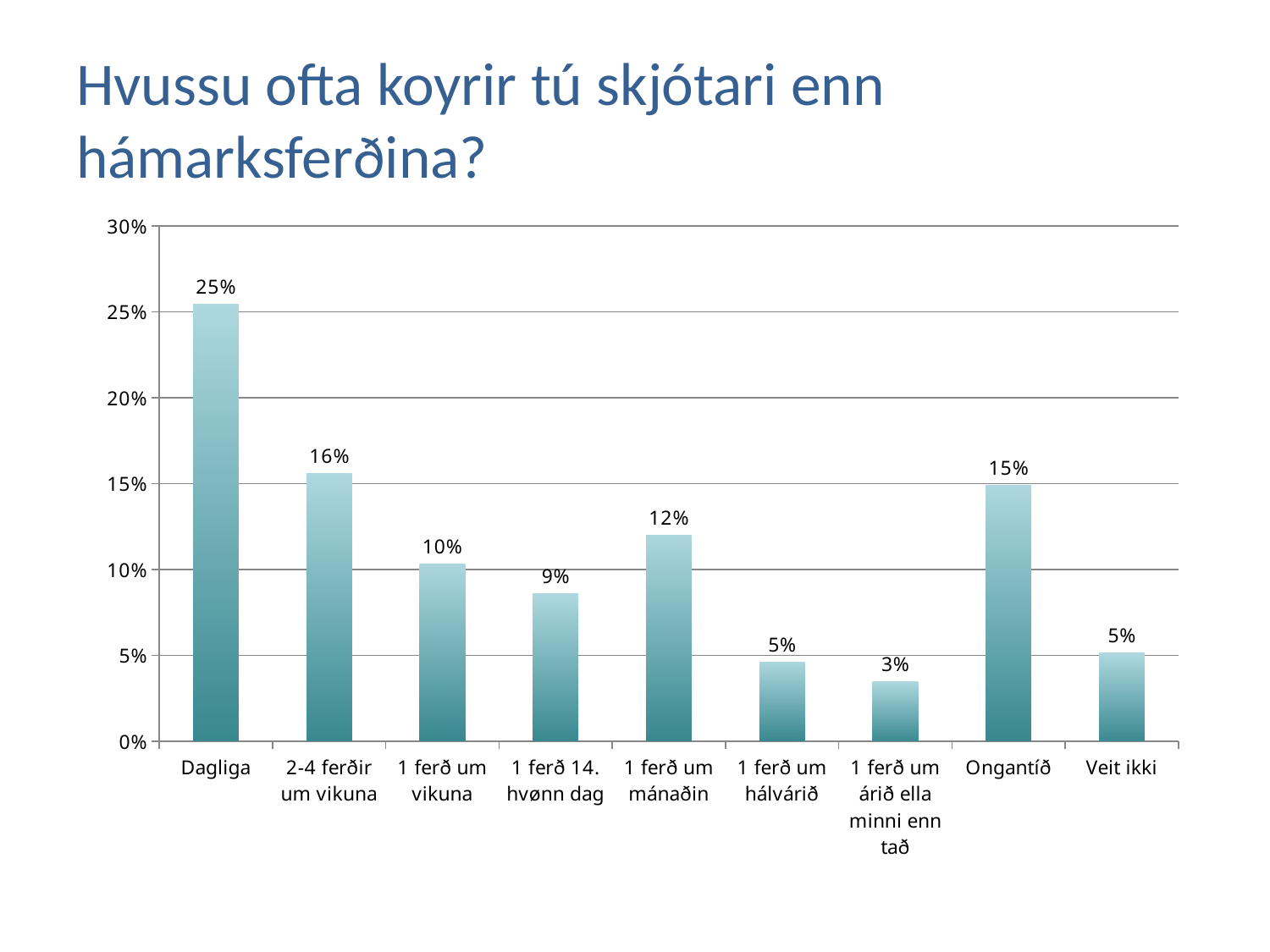
What is the value for 1 ferð um mánaðin? 12% What is the difference between the values for Dagliga and 2-4 ferðir um vikuna? 9% What is the value for Ongantíð? 15% Which is larger, the value for 1 ferð um vikuna or the value for 1 ferð um mánaðin? 1 ferð um mánaðin Is the value for Dagliga greater or less than 20%? greater Which category has the lowest value? 1 ferð um árið ella minni enn tað What is the value for 1 ferð um árið ella minni enn tað? 3% Which category has the highest value? Dagliga How many categories are shown on the x axis? 9 What is the value for Dagliga? 25% What kind of chart is shown on the slide? Bar chart Do the values rise or fall across the first four categories, from Dagliga to 1 ferð 14. hvønn dag? fall